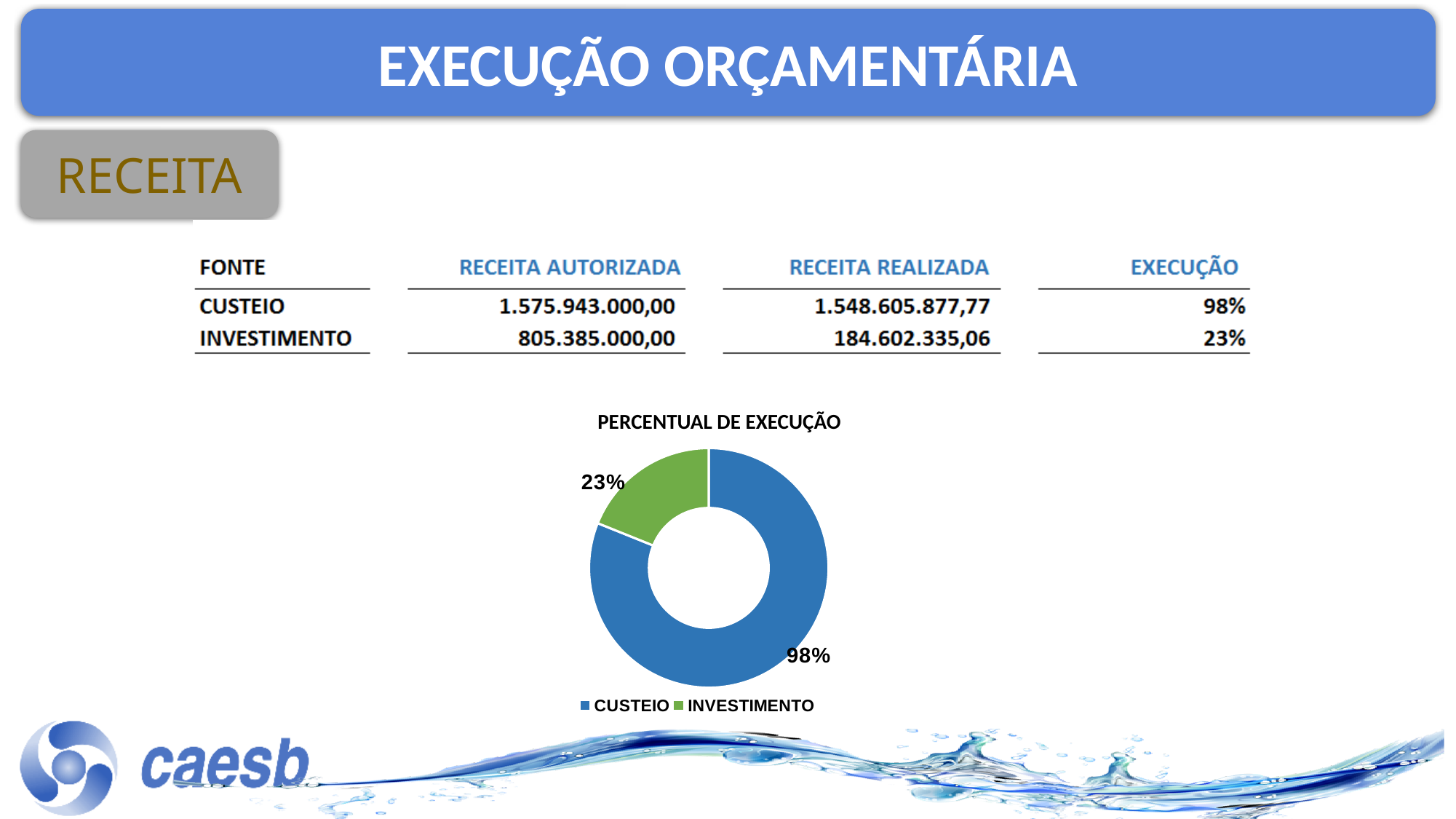
What is the difference between the labelled values for CUSTEIO and INVESTIMENTO in the chart? 75% How many categories does the chart show? 2 What value is labelled on the INVESTIMENTO slice of the chart? 23% Which category has the smaller slice in the chart? INVESTIMENTO How many entries does the chart legend list? 2 What colour is the INVESTIMENTO slice in the chart? Green What is the title of the chart on the slide? PERCENTUAL DE EXECUÇÃO What kind of chart is shown under the title "PERCENTUAL DE EXECUÇÃO"? Doughnut chart What value is labelled on the CUSTEIO slice of the chart? 98% Is the labelled value for CUSTEIO larger or smaller than the labelled value for INVESTIMENTO? Larger Which category has the larger slice in the chart? CUSTEIO